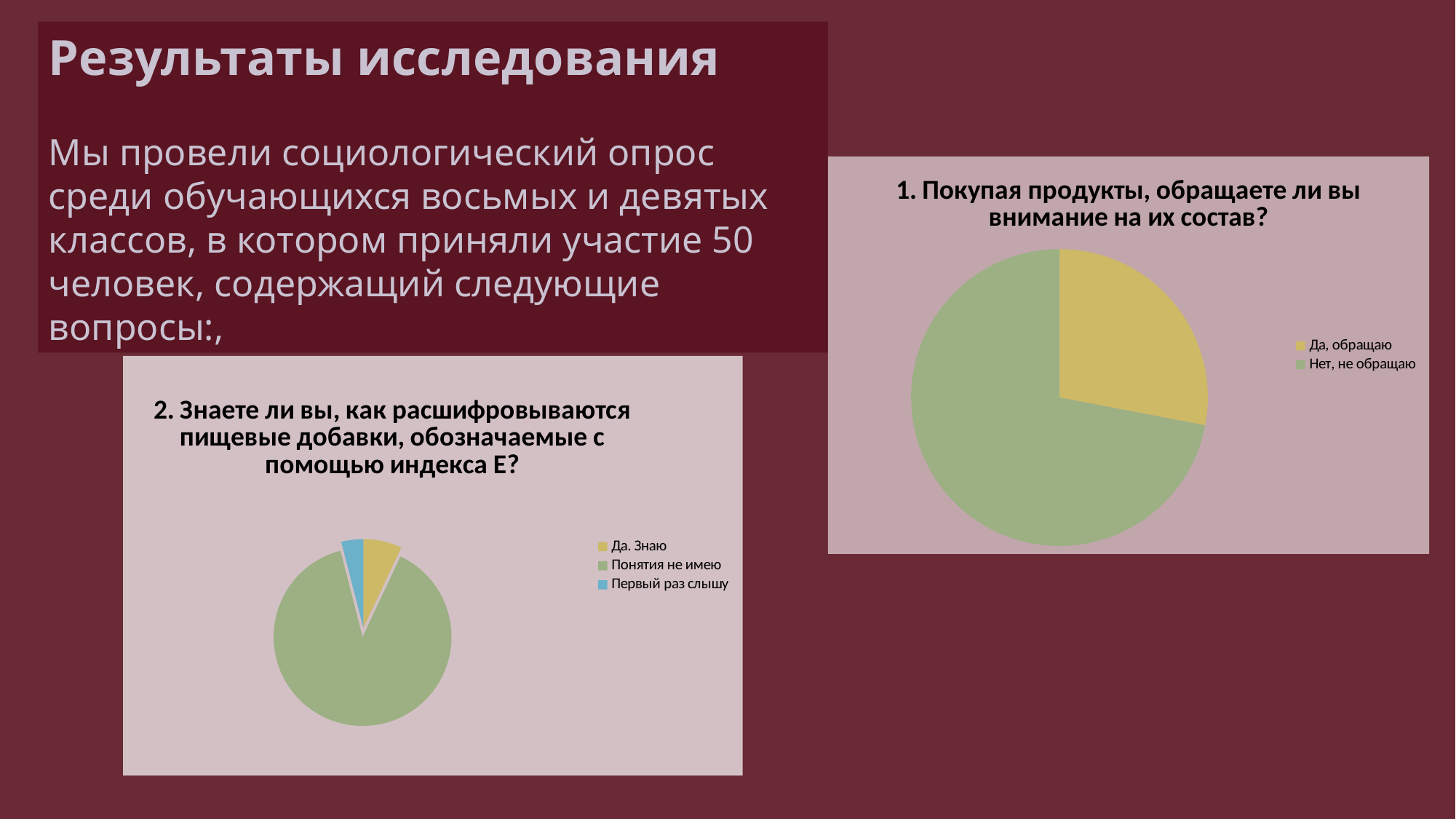
In the chart "1. Покупая продукты, обращаете ли вы внимание на их состав?", which answer has the smallest slice? Да, обращаю In the chart "2. Знаете ли вы, как расшифровываются пищевые добавки, обозначаемые с помощью индекса Е?", which slice is larger: "Да. Знаю" or "Первый раз слышу"? Да. Знаю In the chart "2. Знаете ли вы, как расшифровываются пищевые добавки, обозначаемые с помощью индекса Е?", which answer has the smallest slice? Первый раз слышу In the chart "1. Покупая продукты, обращаете ли вы внимание на их состав?", how many slices does the pie have? 2 In the chart "1. Покупая продукты, обращаете ли вы внимание на их состав?", which slice is larger: "Да, обращаю" or "Нет, не обращаю"? Нет, не обращаю What kind of chart is the chart titled "2. Знаете ли вы, как расшифровываются пищевые добавки, обозначаемые с помощью индекса Е?"? Pie chart What kind of chart is the chart titled "1. Покупая продукты, обращаете ли вы внимание на их состав?"? Pie chart In the chart "1. Покупая продукты, обращаете ли вы внимание на их состав?", what colour is the "Да, обращаю" slice? Yellow In the chart "2. Знаете ли вы, как расшифровываются пищевые добавки, обозначаемые с помощью индекса Е?", which answer has the largest slice? Понятия не имею In the chart "2. Знаете ли вы, как расшифровываются пищевые добавки, обозначаемые с помощью индекса Е?", what colour is the "Первый раз слышу" slice? Blue In the chart "2. Знаете ли вы, как расшифровываются пищевые добавки, обозначаемые с помощью индекса Е?", how many slices does the pie have? 3 In the chart "1. Покупая продукты, обращаете ли вы внимание на их состав?", which answer has the largest slice? Нет, не обращаю